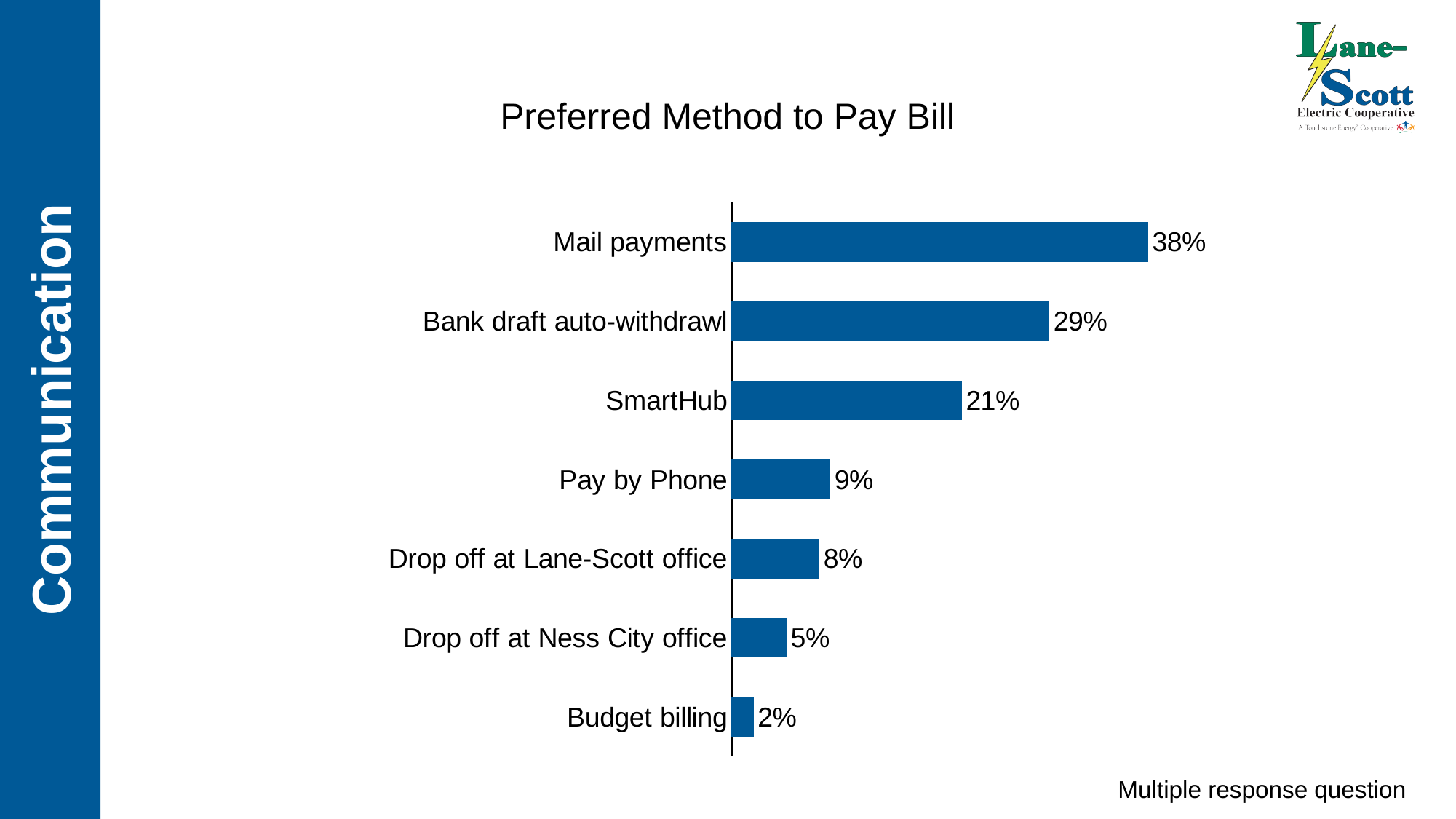
What is the title of the chart? Preferred Method to Pay Bill What is the value for SmartHub? 21% Which payment method has the lowest value? Budget billing What is the value for Mail payments? 38% Which is larger, Bank draft auto-withdrawl or SmartHub? Bank draft auto-withdrawl What kind of chart is shown on the slide? Bar chart What is the difference between SmartHub and Pay by Phone? 12% How many payment methods are shown in the chart? 7 Which payment method has the highest value? Mail payments What is the value for Drop off at Ness City office? 5% What is the difference between Mail payments and Bank draft auto-withdrawl? 9% Which is larger, Pay by Phone or Drop off at Lane-Scott office? Pay by Phone